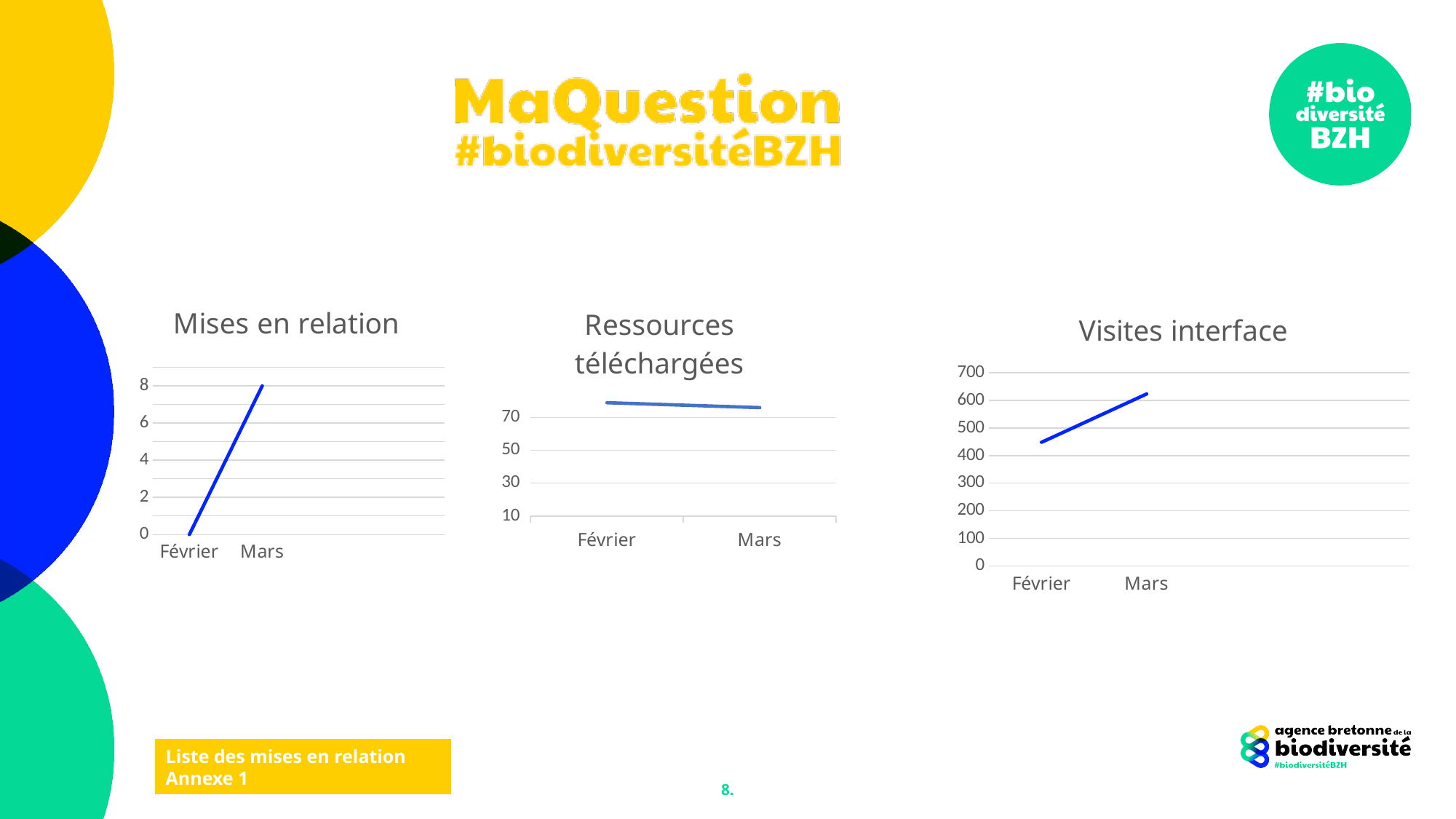
In the 'Visites interface' chart, is the value for Février greater or less than 500? less In the 'Mises en relation' chart, what is the value for Février? 0 In the 'Ressources téléchargées' chart, is the value for Février greater or less than 70? greater What kind of chart is the 'Mises en relation' chart? line chart In the 'Ressources téléchargées' chart, does the value rise or fall from Février to Mars? fall In the 'Mises en relation' chart, what is the value for Mars? 8 In the 'Visites interface' chart, which month has the higher value? Mars What is the title of the middle chart on the slide? Ressources téléchargées In the 'Visites interface' chart, does the value rise or fall from Février to Mars? rise In the 'Visites interface' chart, is the value for Mars greater or less than 600? greater How many categories are shown on the x axis of the 'Mises en relation' chart? 2 In the 'Mises en relation' chart, does the value rise or fall from Février to Mars? rise